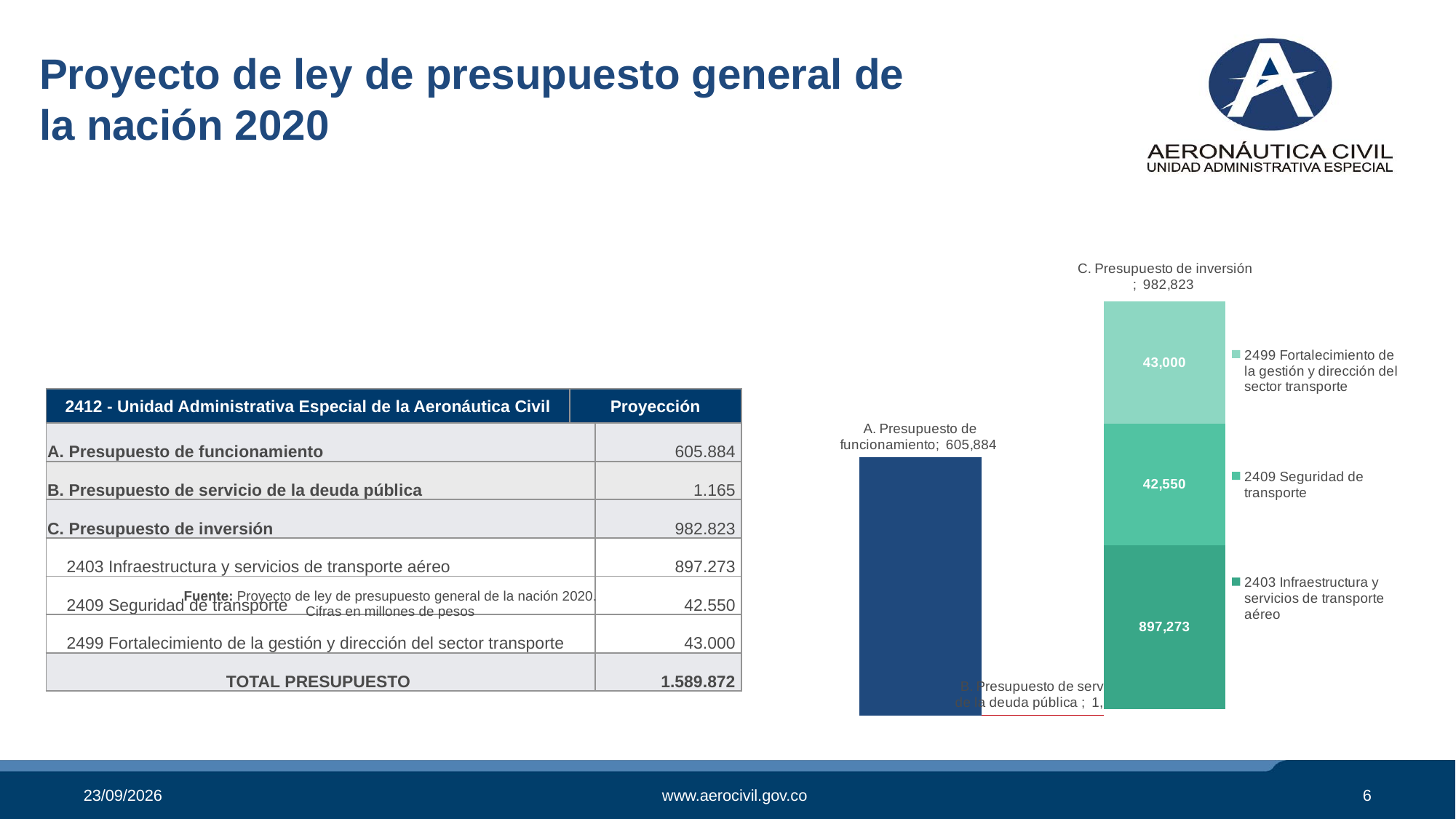
How many series does the chart legend list? 3 In the chart, what is the value of the 2409 Seguridad de transporte segment? 42,550 In the chart, what is the value labelled for A. Presupuesto de funcionamiento? 605,884 Which bar in the chart is the tallest? C. Presupuesto de inversión Which bar in the chart is the shortest? B. Presupuesto de servicio de la deuda pública Which segment of the C. Presupuesto de inversión bar is the largest? 2403 Infraestructura y servicios de transporte aéreo What kind of chart is shown on the right of the slide? Bar chart In the chart, what is the value of the 2499 Fortalecimiento de la gestión y dirección del sector transporte segment? 43,000 In the chart, what is the value of the 2403 Infraestructura y servicios de transporte aéreo segment? 897,273 In the chart, what is the total labelled for C. Presupuesto de inversión? 982,823 What is the difference between the C. Presupuesto de inversión total and the A. Presupuesto de funcionamiento value in the chart? 376,939 In the chart, which is larger: the 2499 Fortalecimiento segment or the 2409 Seguridad de transporte segment? 2499 Fortalecimiento de la gestión y dirección del sector transporte